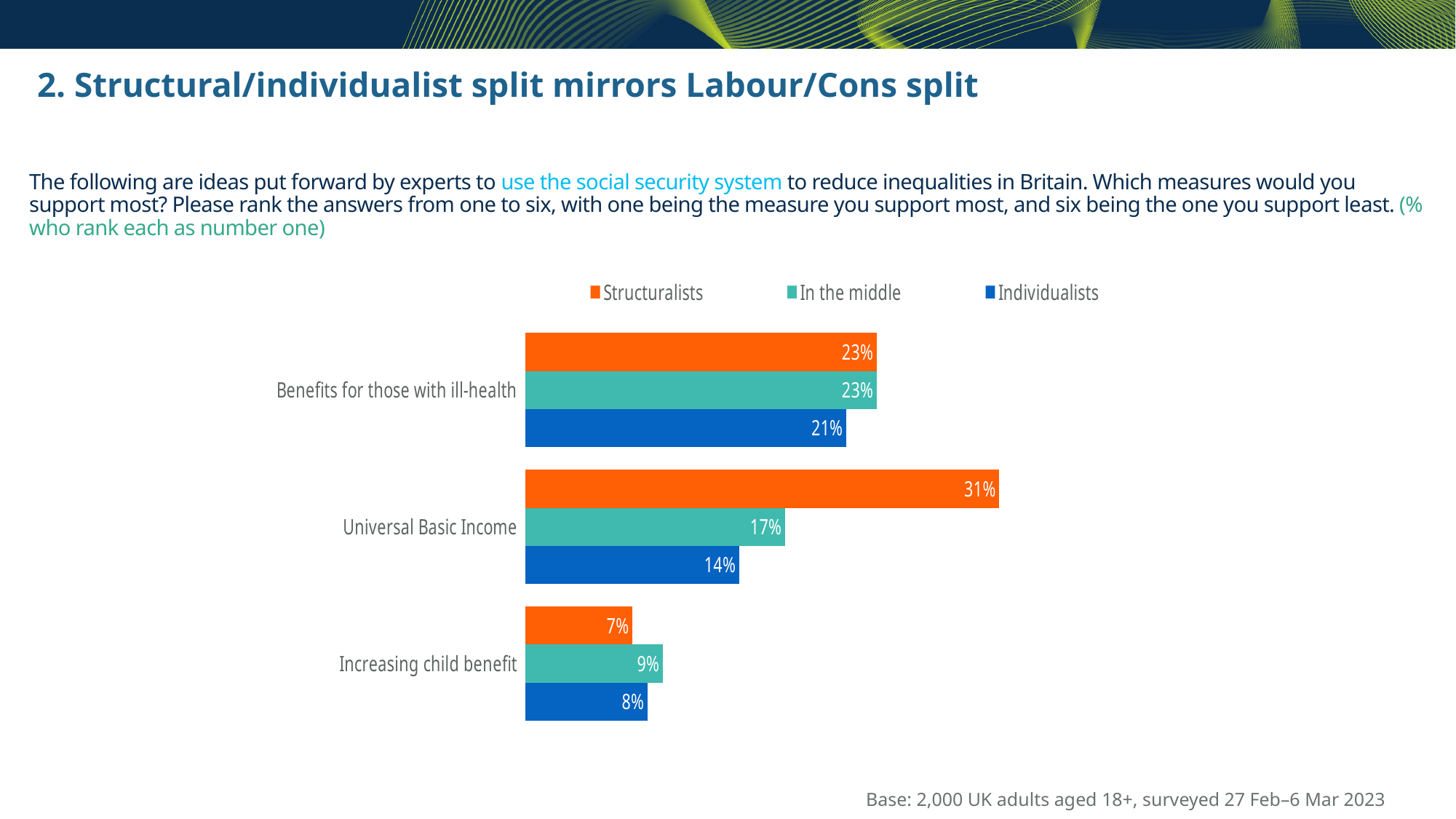
What percentage of Structuralists rank Universal Basic Income as number one? 31% For Increasing child benefit, which group has the larger value: Structuralists or In the middle? In the middle How many measures are shown on the chart? 3 Which measure has the lowest value for Individualists? Increasing child benefit What percentage of Individualists rank Benefits for those with ill-health as number one? 21% Which measure has the highest value for Structuralists? Universal Basic Income How many series does the legend list? 3 What is the difference between the Structuralists and Individualists values for Universal Basic Income? 17% Which colour represents Individualists in the chart? Blue What kind of chart is shown on the slide? Bar chart What is the value for In the middle for Increasing child benefit? 9% What is the value for Individualists for Universal Basic Income? 14%